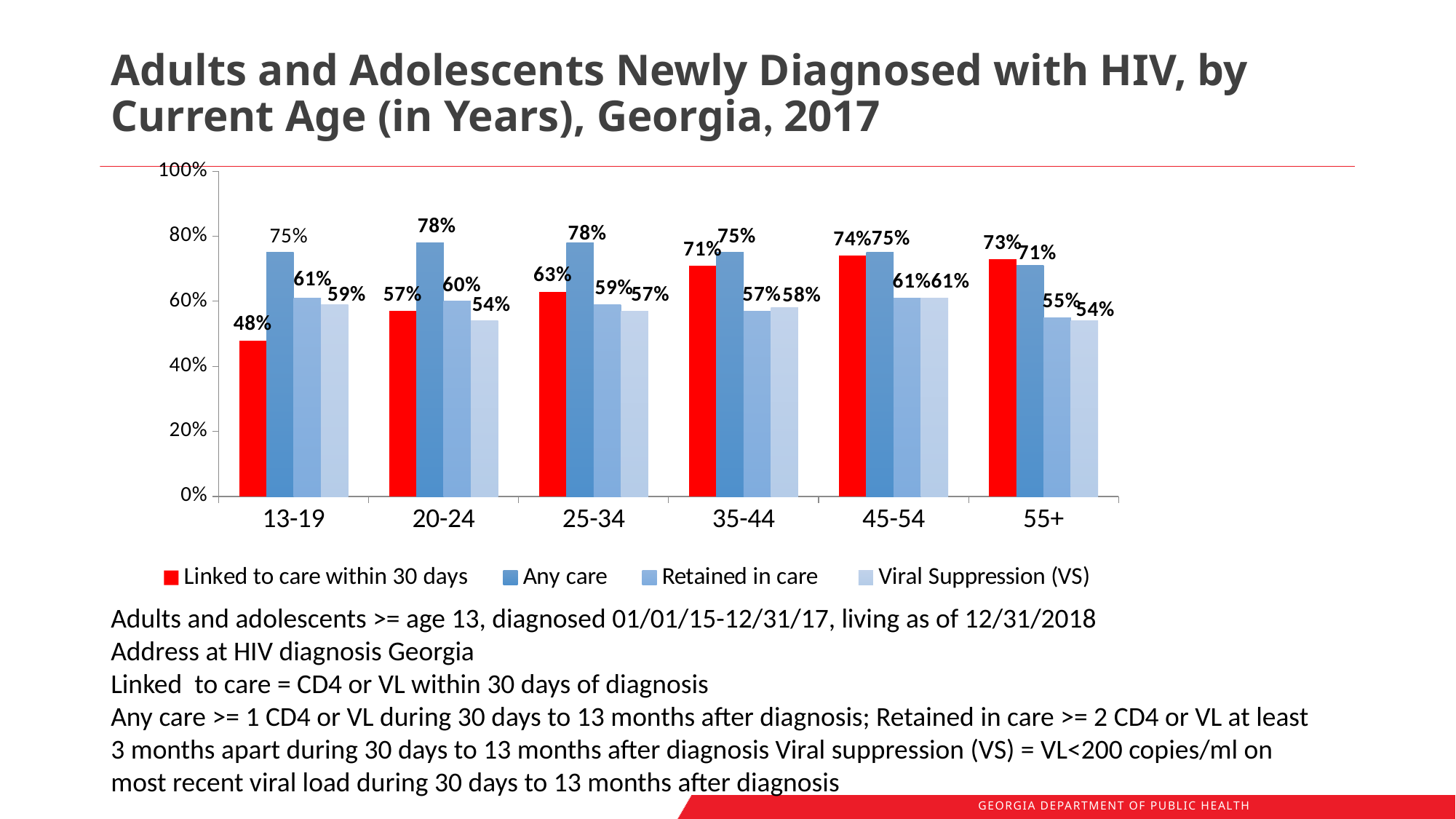
Which age group has the lowest value for Linked to care within 30 days? 13-19 How many age groups are shown on the x axis? 6 Does the Linked to care within 30 days value rise or fall from the 13-19 age group to the 45-54 age group? rise What kind of chart is shown on the slide? bar chart What is the Viral Suppression (VS) value for the 45-54 age group? 61% Which age group has the lowest Retained in care value? 55+ What is the value for Linked to care within 30 days in the 13-19 age group? 48% How many series does the legend list? 4 In the 55+ age group, which is larger: Linked to care within 30 days or Any care? Linked to care within 30 days What is the Any care value for the 25-34 age group? 78% What is the difference between the Any care value and the Linked to care within 30 days value for the 13-19 age group? 27 percentage points Is the Linked to care within 30 days value for the 13-19 age group greater or less than 60%? less